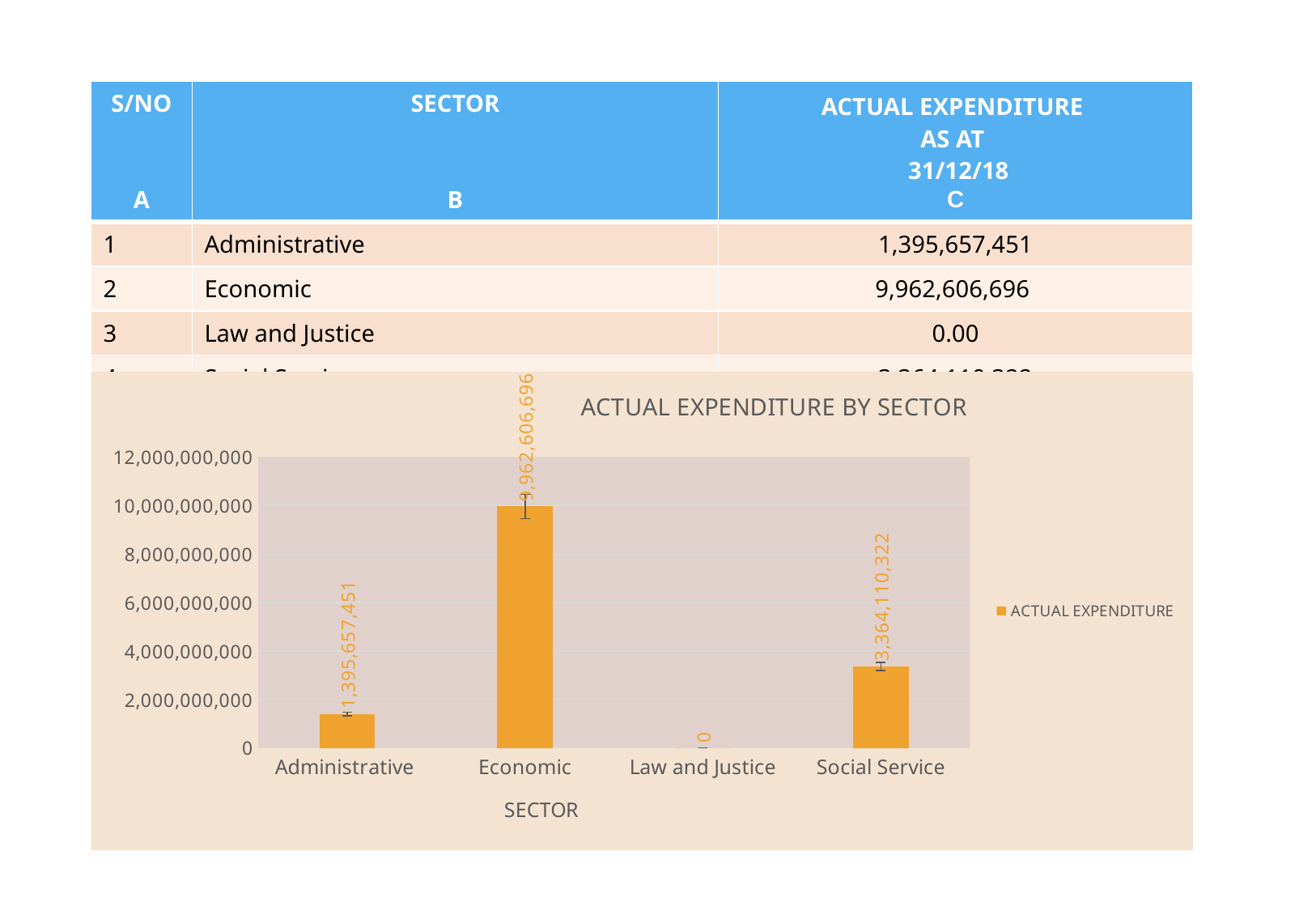
What is the actual expenditure for the Social Service sector in the chart? 3,364,110,322 What is the actual expenditure for the Economic sector in the chart? 9,962,606,696 What is the actual expenditure for the Administrative sector in the chart? 1,395,657,451 What is the difference between the actual expenditure for Social Service and Administrative? 1,968,452,871 What value is shown for Law and Justice in the chart? 0 What is the difference between the actual expenditure for Economic and Social Service? 6,598,496,374 Which sector has the highest actual expenditure in the chart? Economic Which sector has a larger actual expenditure, Administrative or Social Service? Social Service What type of chart is used to show actual expenditure by sector? Bar chart Is the value for Economic greater or less than 8,000,000,000? greater Which sector has the lowest actual expenditure in the chart? Law and Justice How many sectors are shown on the x axis of the chart? 4